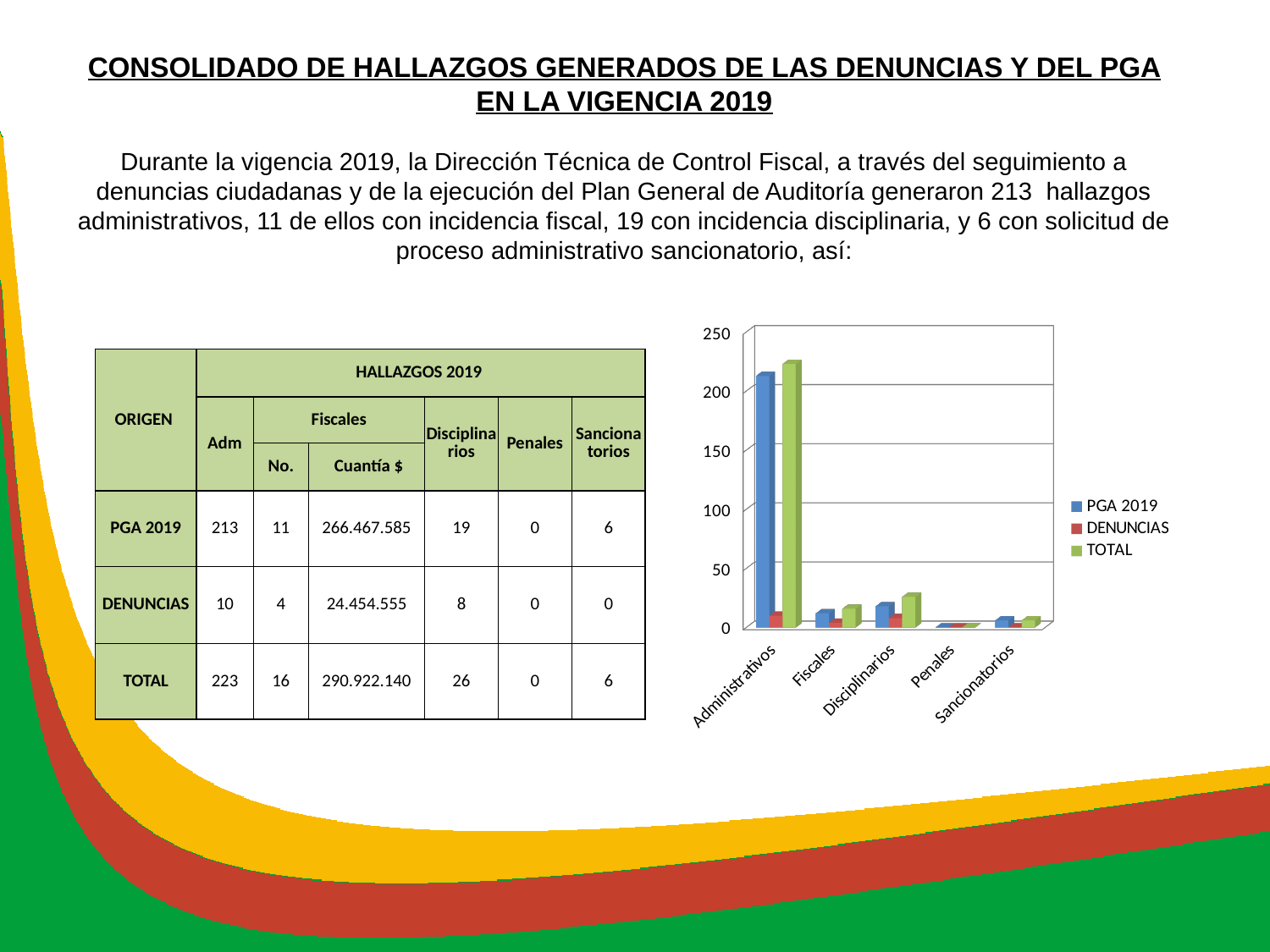
How many series does the chart legend list? 3 Which category has the lowest bars in the chart? Penales How many categories are shown on the x axis of the chart? 5 Which colour represents the TOTAL series in the chart legend? green Which series is shown in blue in the chart? PGA 2019 Is the DENUNCIAS value for Administrativos greater or less than 50? less Which category has the highest TOTAL bar in the chart? Administrativos Is the TOTAL value for Disciplinarios greater or less than 50? less For Administrativos, which series has the larger bar: PGA 2019 or DENUNCIAS? PGA 2019 What kind of chart is shown on the slide? bar chart Is the TOTAL value for Administrativos greater or less than 200? greater For the TOTAL series, which category has the larger bar: Fiscales or Disciplinarios? Disciplinarios